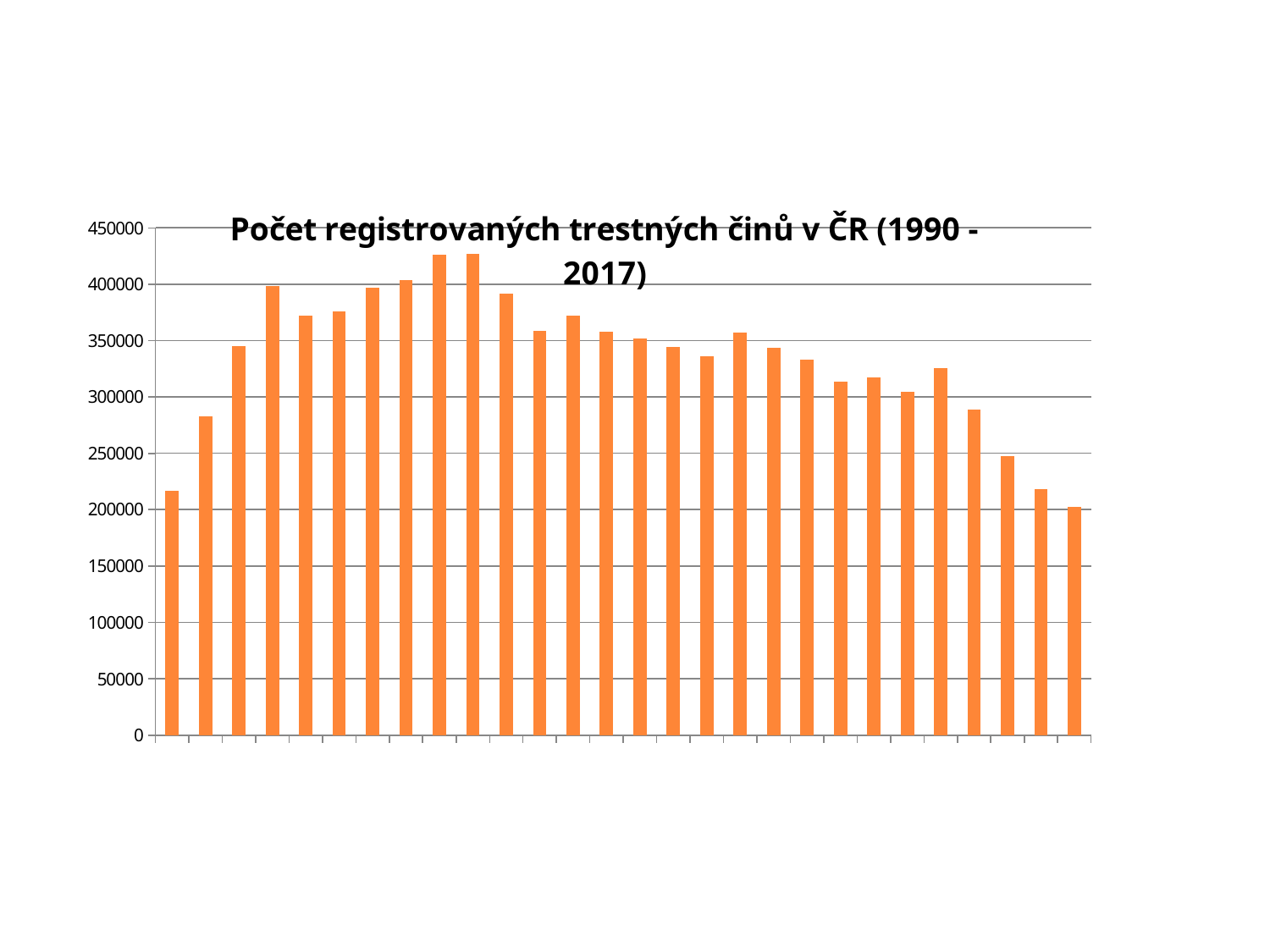
Is the value of the last bar greater or less than 250000? less Which is larger, the value of the first bar or the last bar? the first bar Do the values rise or fall across the first four bars of the chart? rise What is the title of the chart? Počet registrovaných trestných činů v ČR (1990 - 2017) Is the value of the second bar greater or less than 300000? less What colour are the bars in the chart? orange Is the value of the tallest bar greater or less than 400000? greater Do the values rise or fall across the last five bars of the chart? fall What kind of chart is shown on the slide? bar chart Which is larger, the value of the third bar or the fourth bar? the fourth bar How many bars are plotted in the chart? 28